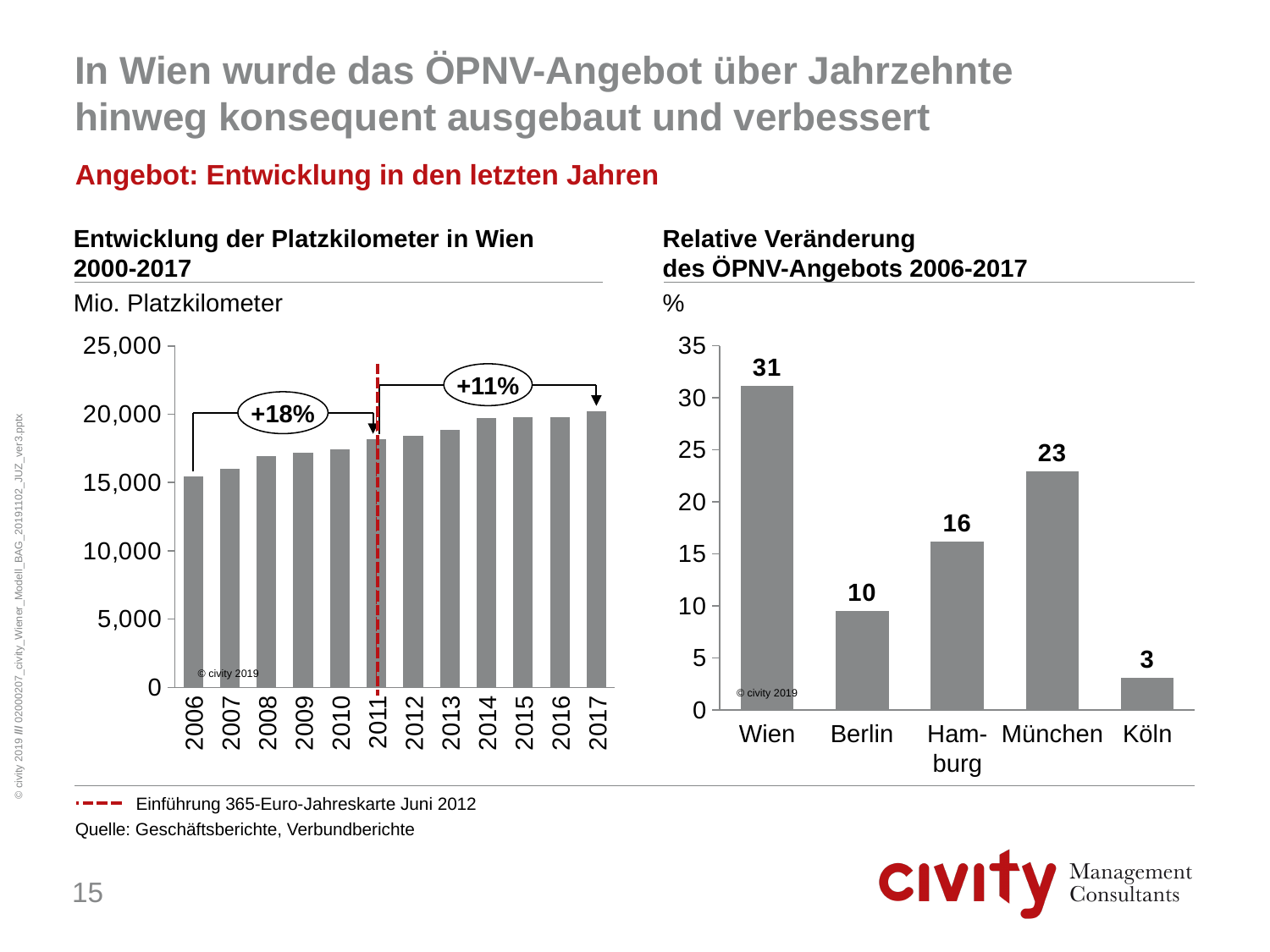
In the chart 'Relative Veränderung des ÖPNV-Angebots 2006-2017', which city has the highest value? Wien In the chart 'Entwicklung der Platzkilometer in Wien 2000-2017', is the value for 2006 greater or less than 20,000? less In the chart 'Relative Veränderung des ÖPNV-Angebots 2006-2017', what is the value for Wien? 31 In the chart 'Entwicklung der Platzkilometer in Wien 2000-2017', do the values rise or fall from 2006 to 2017? rise In the chart 'Relative Veränderung des ÖPNV-Angebots 2006-2017', which is larger, the value for Hamburg or the value for München? München How many cities are shown in the chart 'Relative Veränderung des ÖPNV-Angebots 2006-2017'? 5 In the chart 'Relative Veränderung des ÖPNV-Angebots 2006-2017', what is the difference between the values for München and Berlin? 13 What kind of chart is 'Entwicklung der Platzkilometer in Wien 2000-2017'? Bar chart In the chart 'Relative Veränderung des ÖPNV-Angebots 2006-2017', what is the value for Hamburg? 16 In the chart 'Relative Veränderung des ÖPNV-Angebots 2006-2017', which city has the lowest value? Köln In the chart 'Entwicklung der Platzkilometer in Wien 2000-2017', what percentage change is annotated for the period from 2011 to 2017? +11% How many years are shown on the x axis of the chart 'Entwicklung der Platzkilometer in Wien 2000-2017'? 12